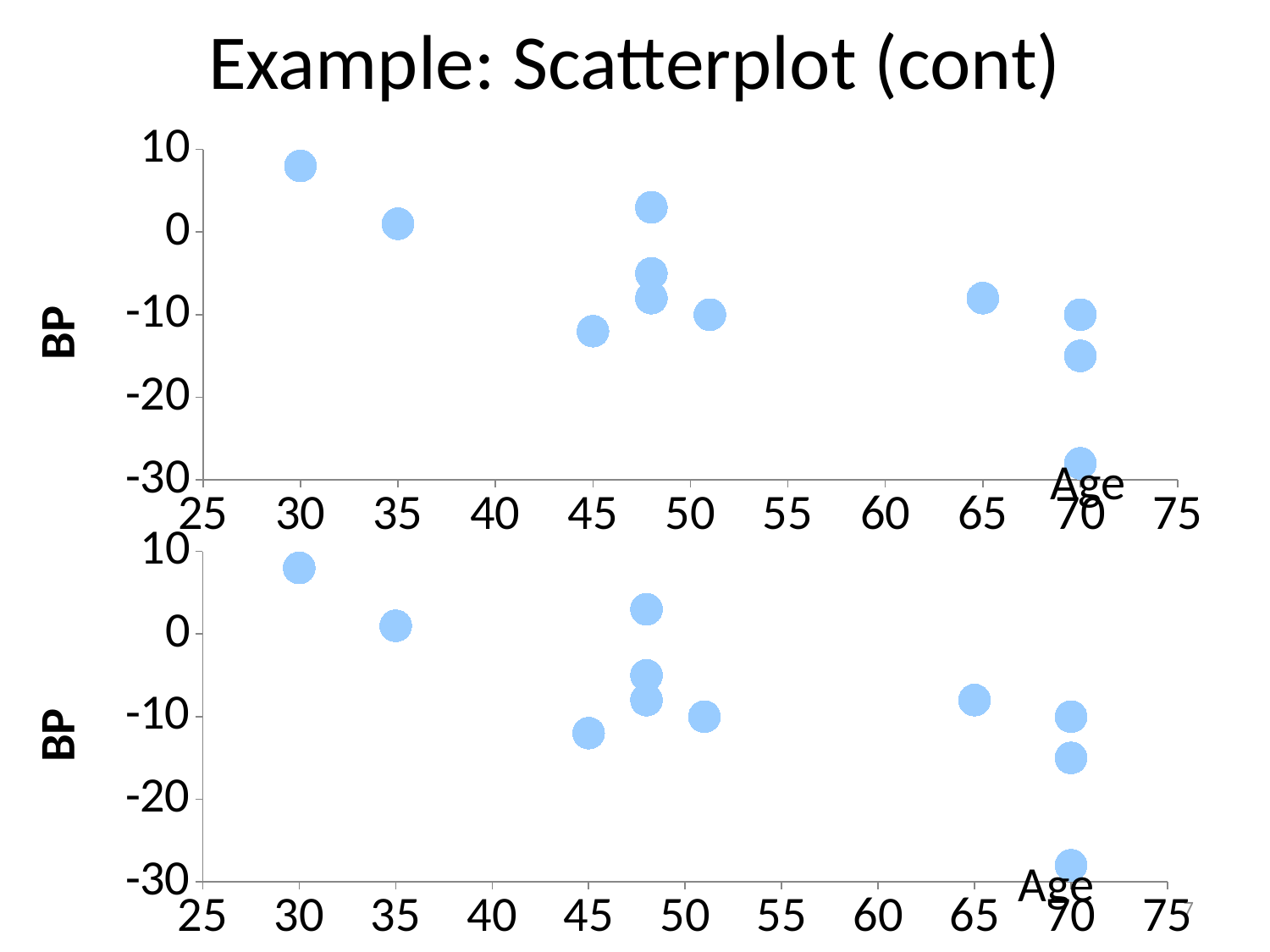
In the bottom chart, at which age is the lowest BP value plotted? 70 In the bottom chart, is the BP value of the lowest point greater or less than -20? less In the top chart, at which age is the highest BP value plotted? 30 In the bottom chart, do BP values generally rise or fall as age increases? fall In the top chart, is the BP value for the point at age 30 greater or less than 0? greater In the bottom chart, is the BP value for the point at age 35 greater or less than -10? greater In the top chart, what is the label of the vertical axis? BP What kind of chart is shown at the top of the slide? scatter plot In the top chart, which point has the higher BP value: the one at age 30 or the one at age 45? age 30 In the bottom chart, what is the label of the horizontal axis? Age In the top chart, how many data points are plotted? 11